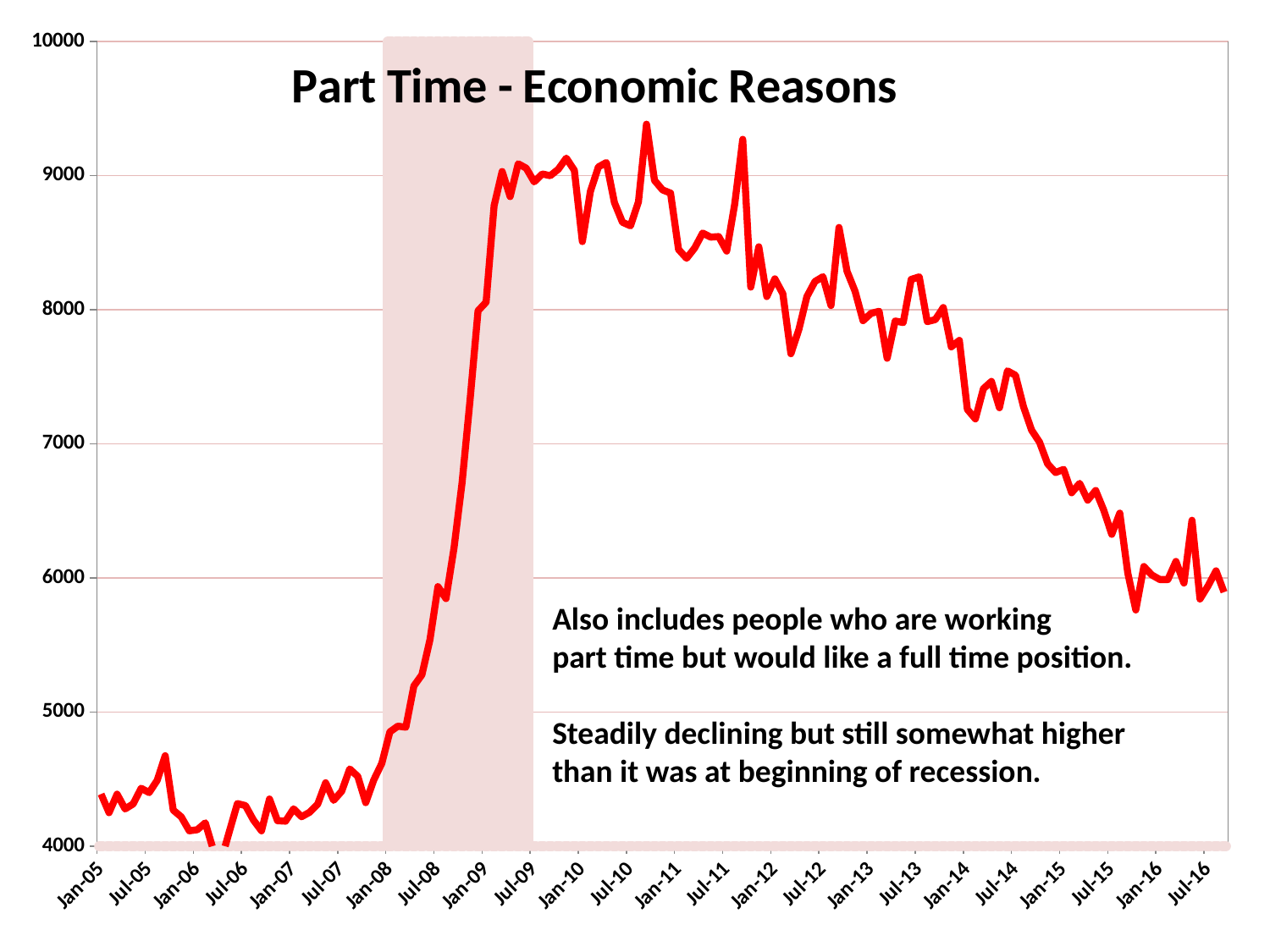
Does the line rise or fall between Jan-08 and Jan-09? rise Is the value for Jan-10 greater or less than 8000? greater What is the title of the chart? Part Time - Economic Reasons Is the value for Jan-05 greater or less than 5000? less Which is larger, the value for Jan-05 or the value for Jan-10? Jan-10 What is the highest value shown on the vertical axis? 10000 Is the value for Jul-09 greater or less than 8000? greater Does the line rise or fall between Jan-12 and Jul-16? fall What kind of chart is shown on the slide? line chart